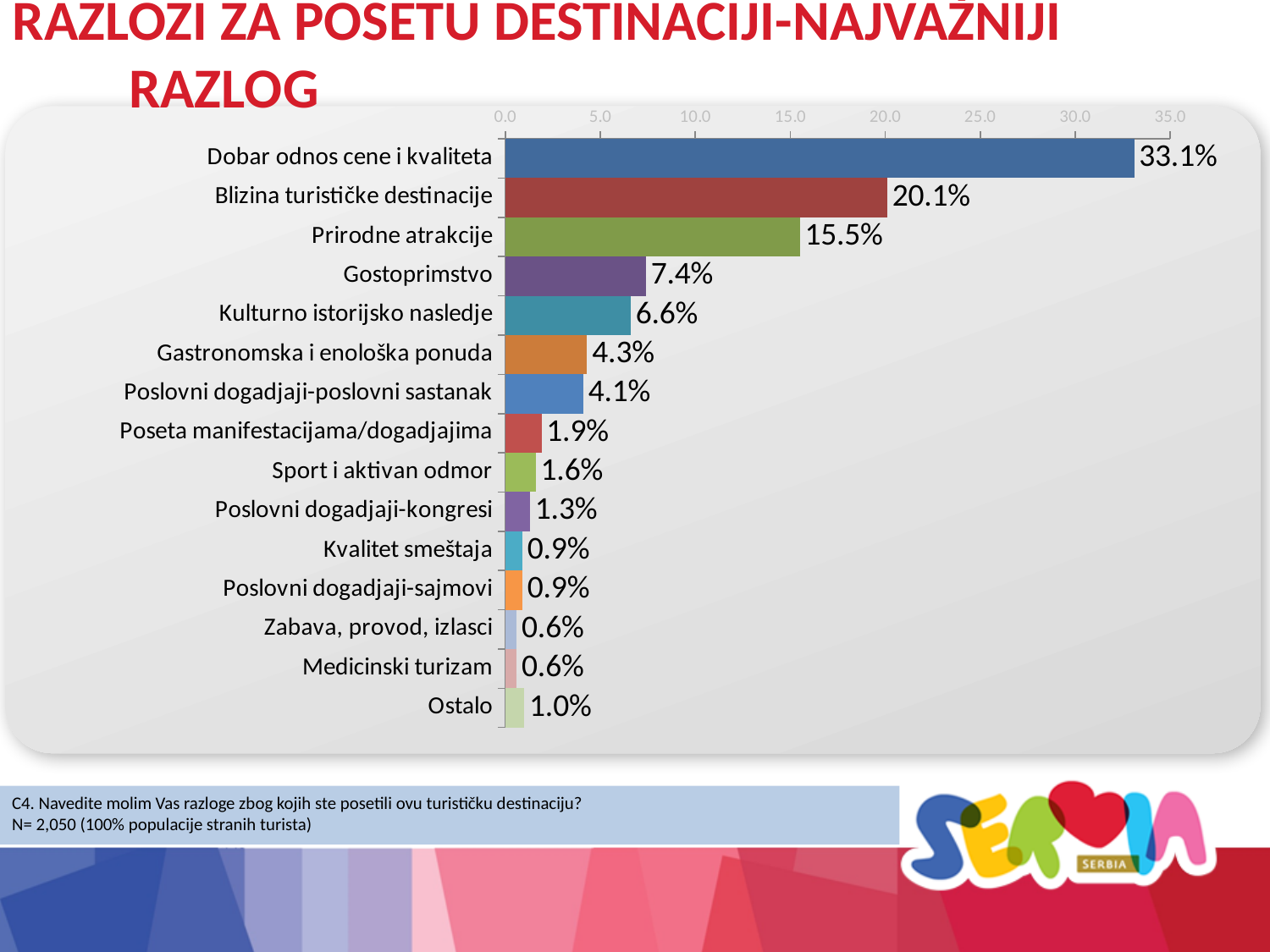
What is the value for Dobar odnos cene i kvaliteta? 33.1% Which is larger, Gastronomska i enološka ponuda or Poslovni dogadjaji-poslovni sastanak? Gastronomska i enološka ponuda What is the value for Kulturno istorijsko nasledje? 6.6% What kind of chart is shown on the slide? bar chart What is the difference between Prirodne atrakcije and Gostoprimstvo? 8.1% What is the sample size (N) stated below the chart? 2,050 What is the value for Prirodne atrakcije? 15.5% What is the value for Ostalo? 1.0% How many categories are shown in the chart? 15 What is the difference between Dobar odnos cene i kvaliteta and Blizina turističke destinacije? 13.0% Is the value for Gostoprimstvo greater or less than 5.0? greater Which category has the highest value? Dobar odnos cene i kvaliteta